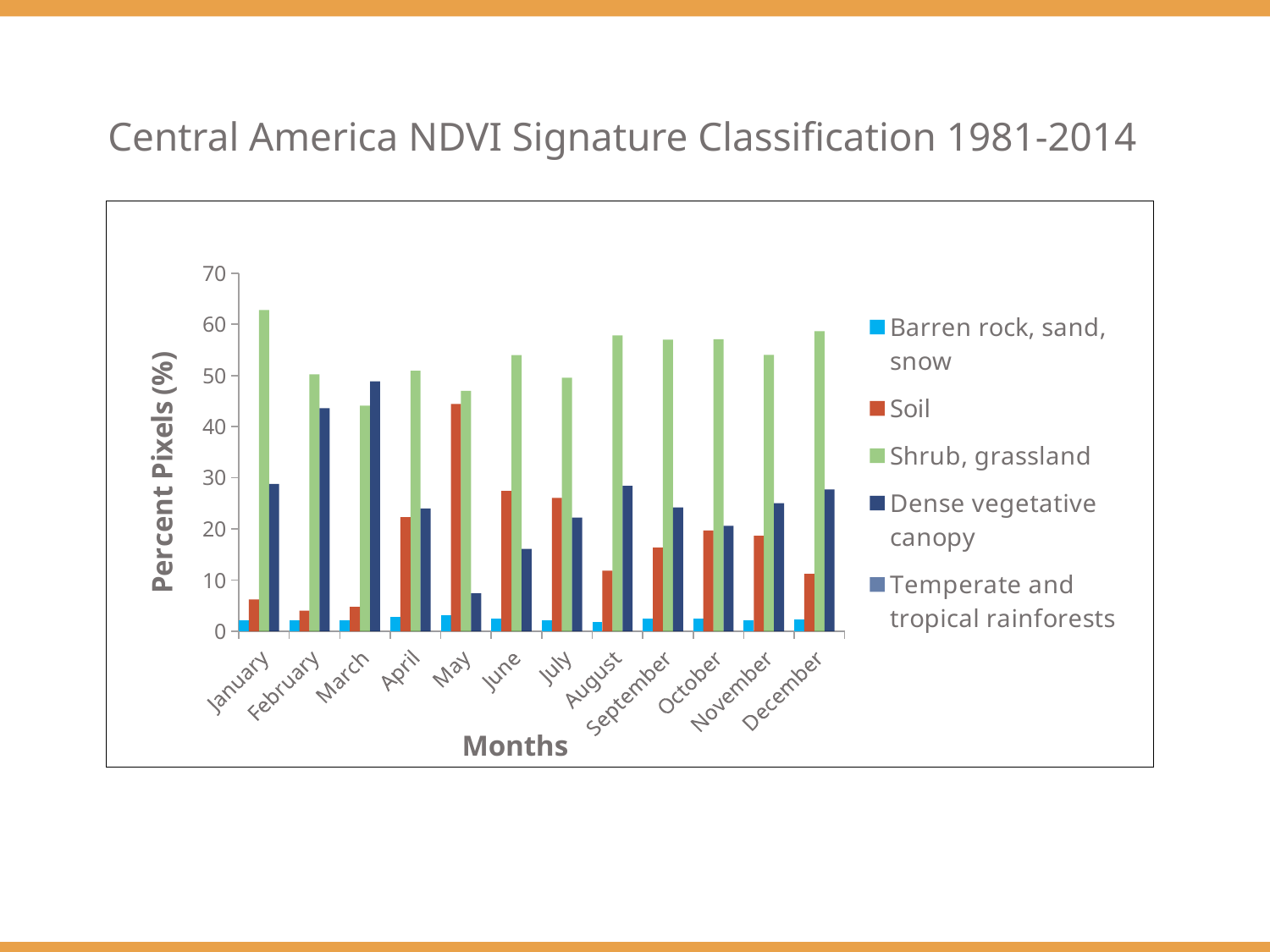
How many months are shown along the x axis? 12 What is the title of the y axis? Percent Pixels (%) In February, which is larger: Soil or Dense vegetative canopy? Dense vegetative canopy In which month is the Shrub, grassland value highest? January In March, which is larger: Dense vegetative canopy or Shrub, grassland? Dense vegetative canopy In which month is the Dense vegetative canopy value lowest? May Is the Soil value for May greater or less than 40? greater Is the Shrub, grassland value for January greater or less than 60? greater In which month is the Dense vegetative canopy value highest? March How many series does the legend list? 5 What kind of chart is shown on the slide? Bar chart In which month is the Soil value highest? May